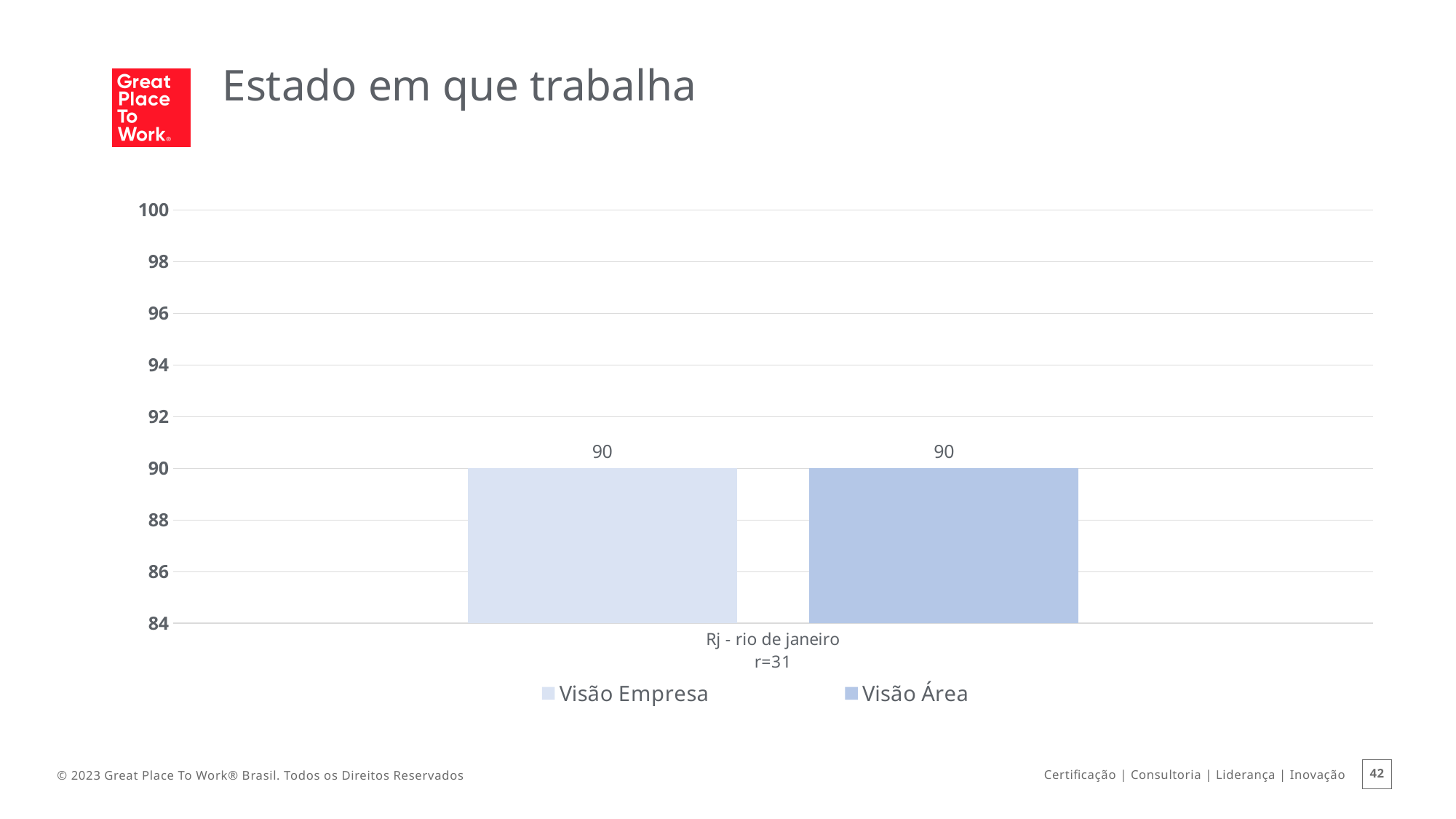
What are the two series listed in the chart legend? Visão Empresa and Visão Área What is the value for Visão Empresa for Rj - rio de janeiro? 90 How many series does the legend list? 2 What kind of chart is shown on the slide? bar chart How many categories are shown on the x axis of the chart? 1 What is the r value shown under the category label Rj - rio de janeiro? r=31 Is the value for Visão Empresa greater or less than 92? less Is the value for Visão Área greater or less than 88? greater What is the lowest value shown on the y axis of the chart? 84 What is the value for Visão Área for Rj - rio de janeiro? 90 What is the difference between the Visão Empresa and Visão Área values for Rj - rio de janeiro? 0 What is the title of the slide containing the chart? Estado em que trabalha